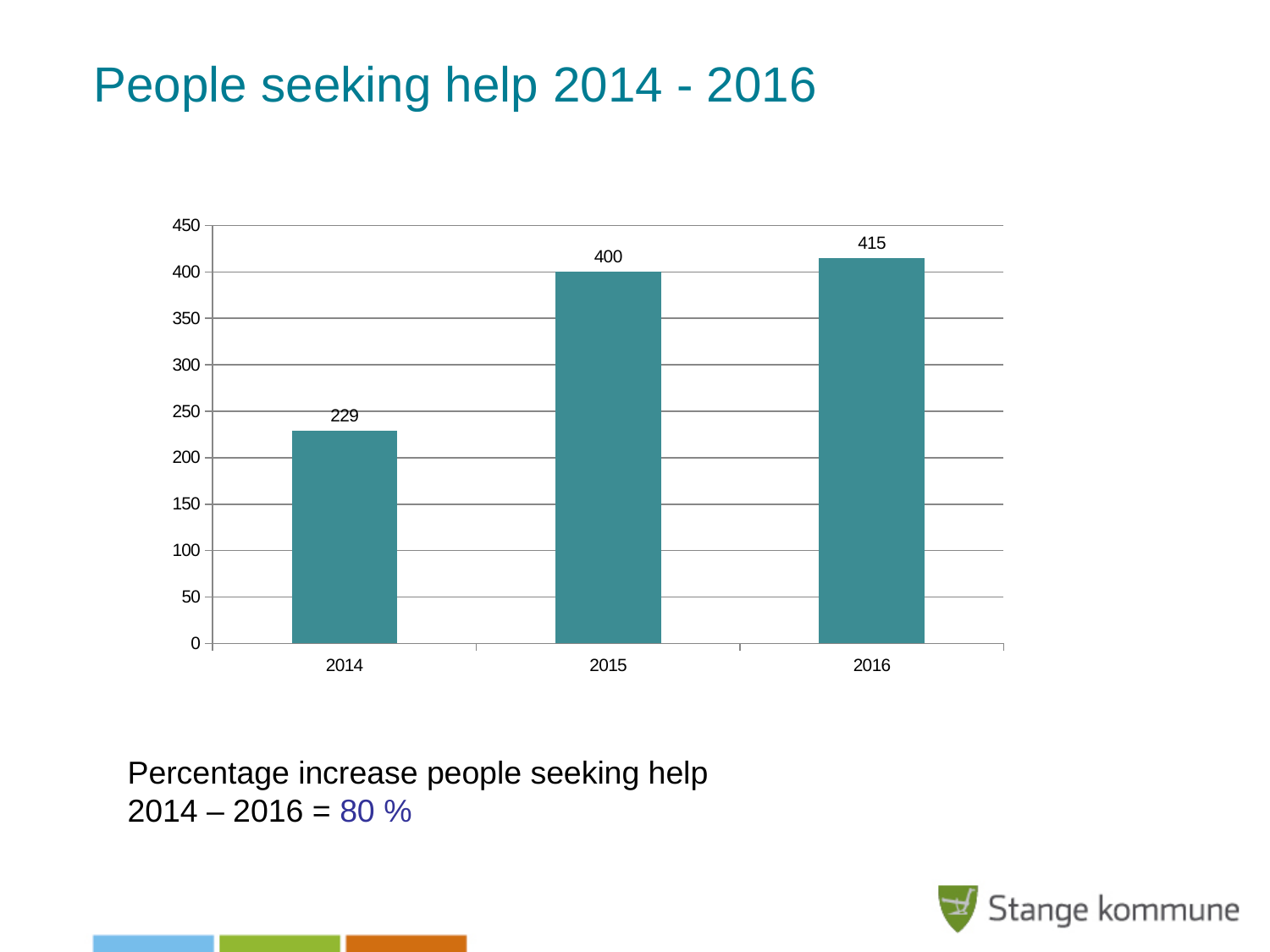
What is the value for 2016? 415 Which is larger, the value for 2014 or the value for 2015? 2015 What is the value for 2015? 400 What is the difference between the values for 2015 and 2014? 171 Is the value for 2014 greater or less than 250? less What is the difference between the values for 2016 and 2015? 15 Which year has the highest value? 2016 How many years are shown on the x axis? 3 What is the value for 2014? 229 What kind of chart is shown on the slide? bar chart Which year has the lowest value? 2014 Do the values rise or fall from 2014 to 2016? rise